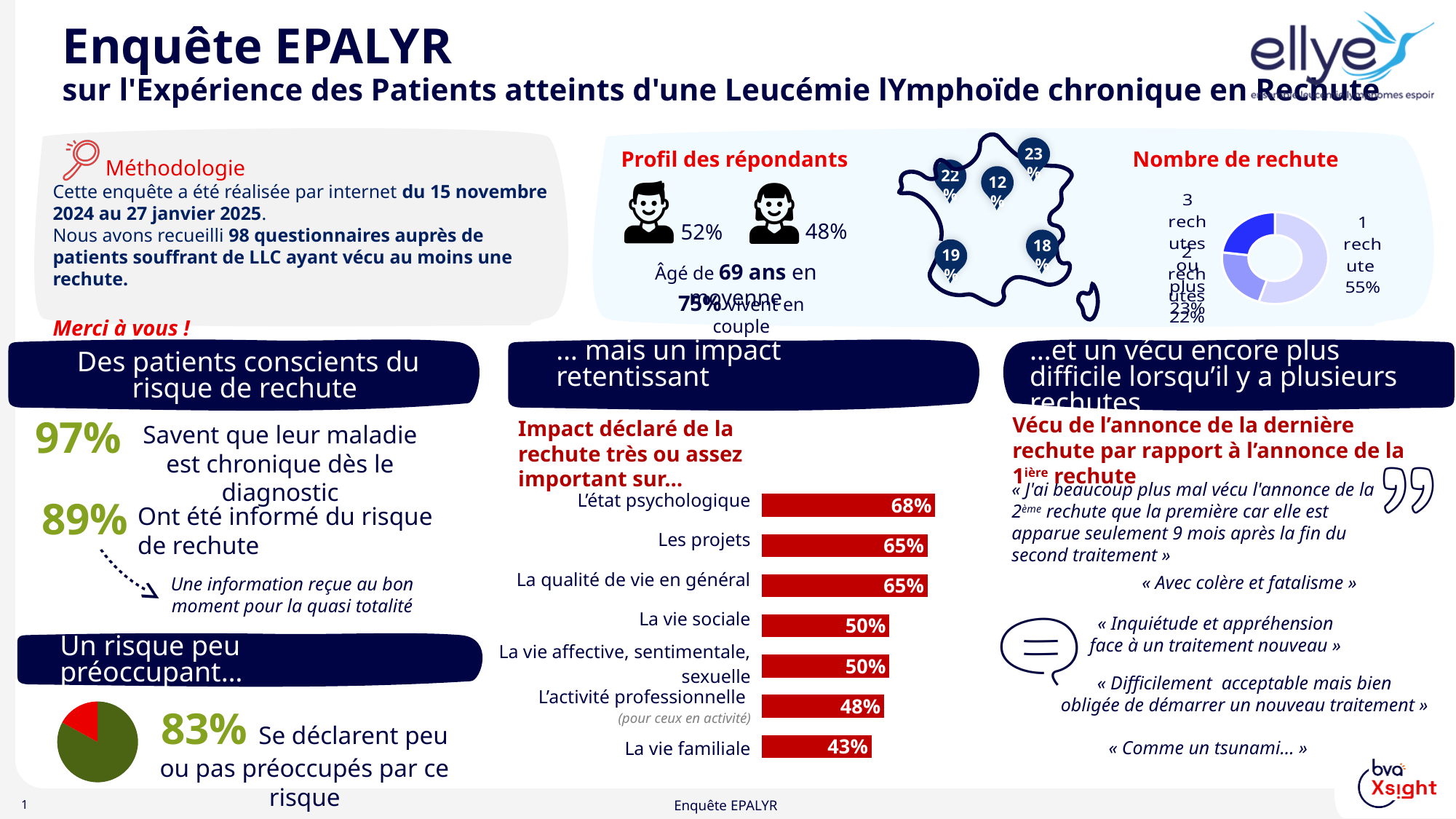
What kind of chart is the 'Nombre de rechute' chart? Donut chart In the bar chart 'Impact déclaré de la rechute très ou assez important sur…', what is the value for 'La vie sociale'? 50% In the bar chart 'Impact déclaré de la rechute très ou assez important sur…', what colour are the bars? Red How many categories are shown in the bar chart 'Impact déclaré de la rechute très ou assez important sur…'? 7 In the bar chart 'Impact déclaré de la rechute très ou assez important sur…', which category has the lowest value? La vie familiale In the bar chart 'Impact déclaré de la rechute très ou assez important sur…', what is the difference between 'L'état psychologique' and 'La vie familiale'? 25 percentage points In the bar chart 'Impact déclaré de la rechute très ou assez important sur…', which is larger: 'Les projets' or 'L'activité professionnelle'? Les projets In the 'Nombre de rechute' chart, what share of respondents had 1 rechute? 55% What kind of chart is used for 'Impact déclaré de la rechute très ou assez important sur…'? Bar chart In the bar chart 'Impact déclaré de la rechute très ou assez important sur…', what is the value for 'L'état psychologique'? 68% In the bar chart 'Impact déclaré de la rechute très ou assez important sur…', which category has the highest value? L'état psychologique In the bar chart 'Impact déclaré de la rechute très ou assez important sur…', what is the value for 'La vie familiale'? 43%